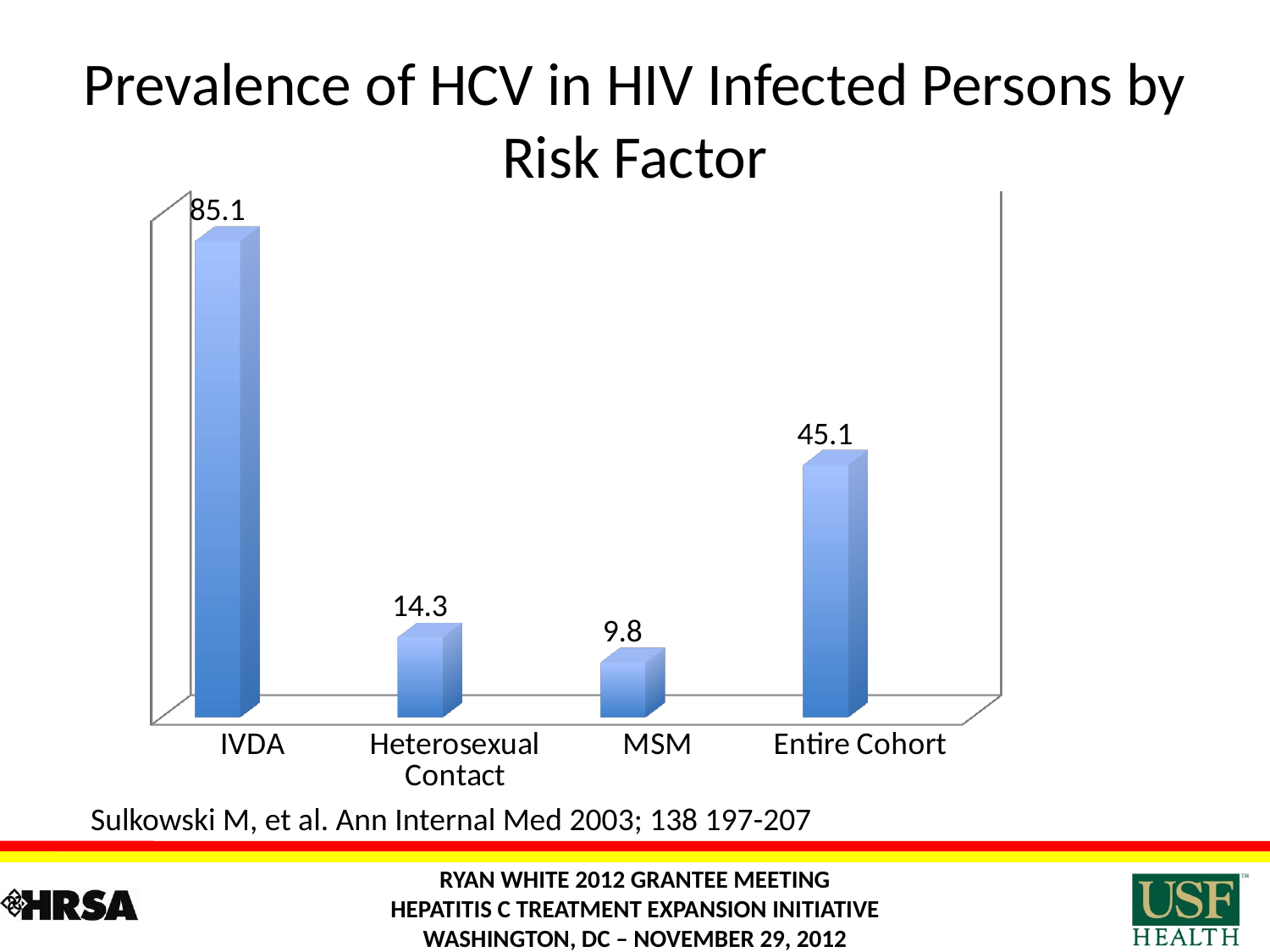
What is the value for IVDA? 85.1 What is the difference between the values for Heterosexual Contact and MSM? 4.5 Which category has the highest value? IVDA What is the value for Entire Cohort? 45.1 How many categories are shown on the x axis? 4 What is the value for MSM? 9.8 What is the title of the chart? Prevalence of HCV in HIV Infected Persons by Risk Factor Which category has the lowest value? MSM What is the value for Heterosexual Contact? 14.3 Which is larger, the value for Heterosexual Contact or the value for MSM? Heterosexual Contact What is the difference between the values for IVDA and Entire Cohort? 40 What kind of chart is shown on the slide? Bar chart